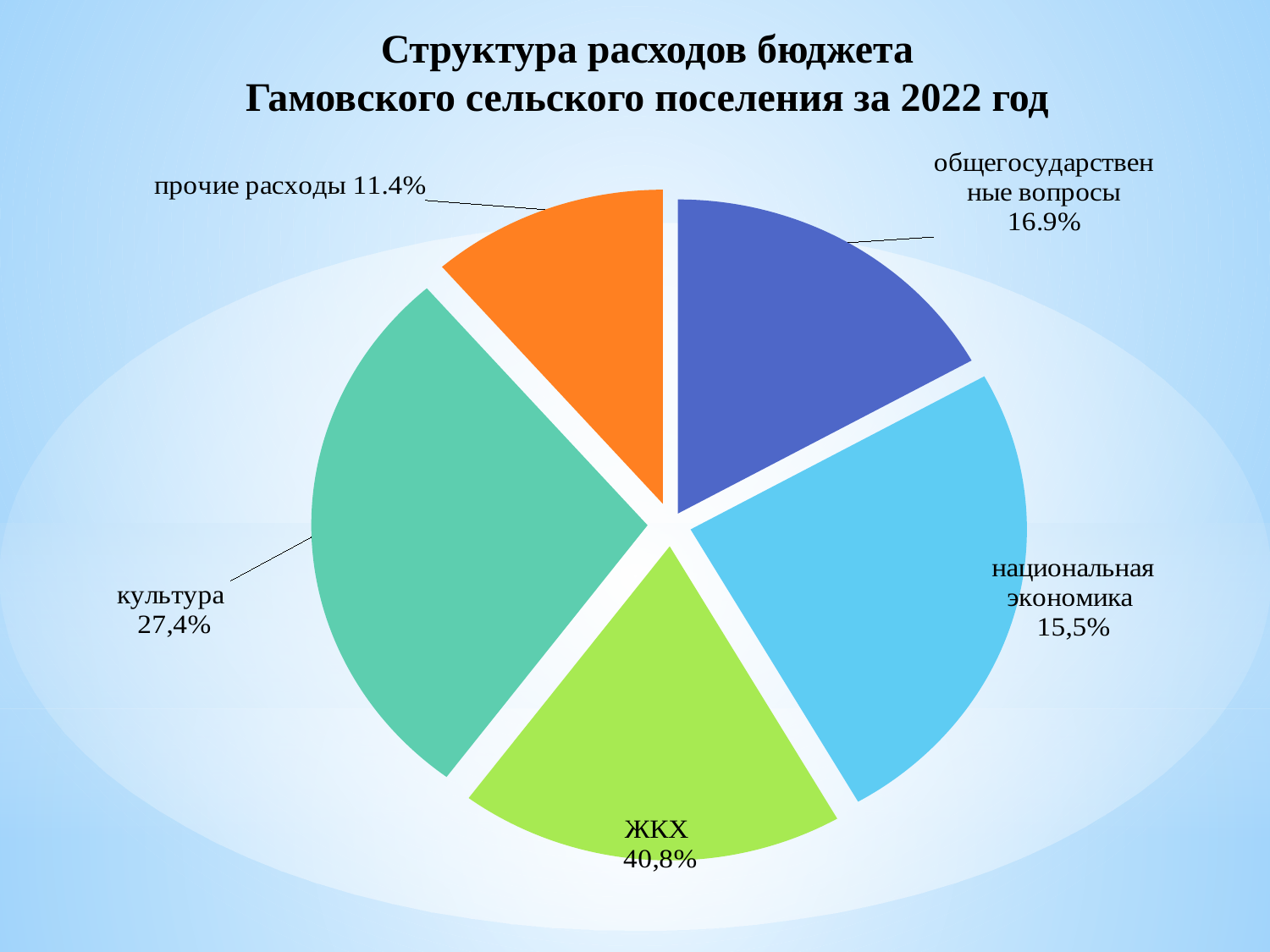
What colour is the slice for ЖКХ? light green Which is larger, the share for культура or the share for прочие расходы? культура What value is printed for общегосударственные вопросы? 16.9% What percentage is shown for культура? 27,4% What share of the pie is labelled for ЖКХ? 40,8% What type of chart is shown on the slide? pie chart How many slices does the pie chart have? 5 Which category has the smallest share of the pie? прочие расходы What is the title of the chart? Структура расходов бюджета Гамовского сельского поселения за 2022 год What is the difference between the labelled shares of ЖКХ and культура? 13,4% What percentage is shown for национальная экономика? 15,5% What share is labelled for прочие расходы? 11.4%